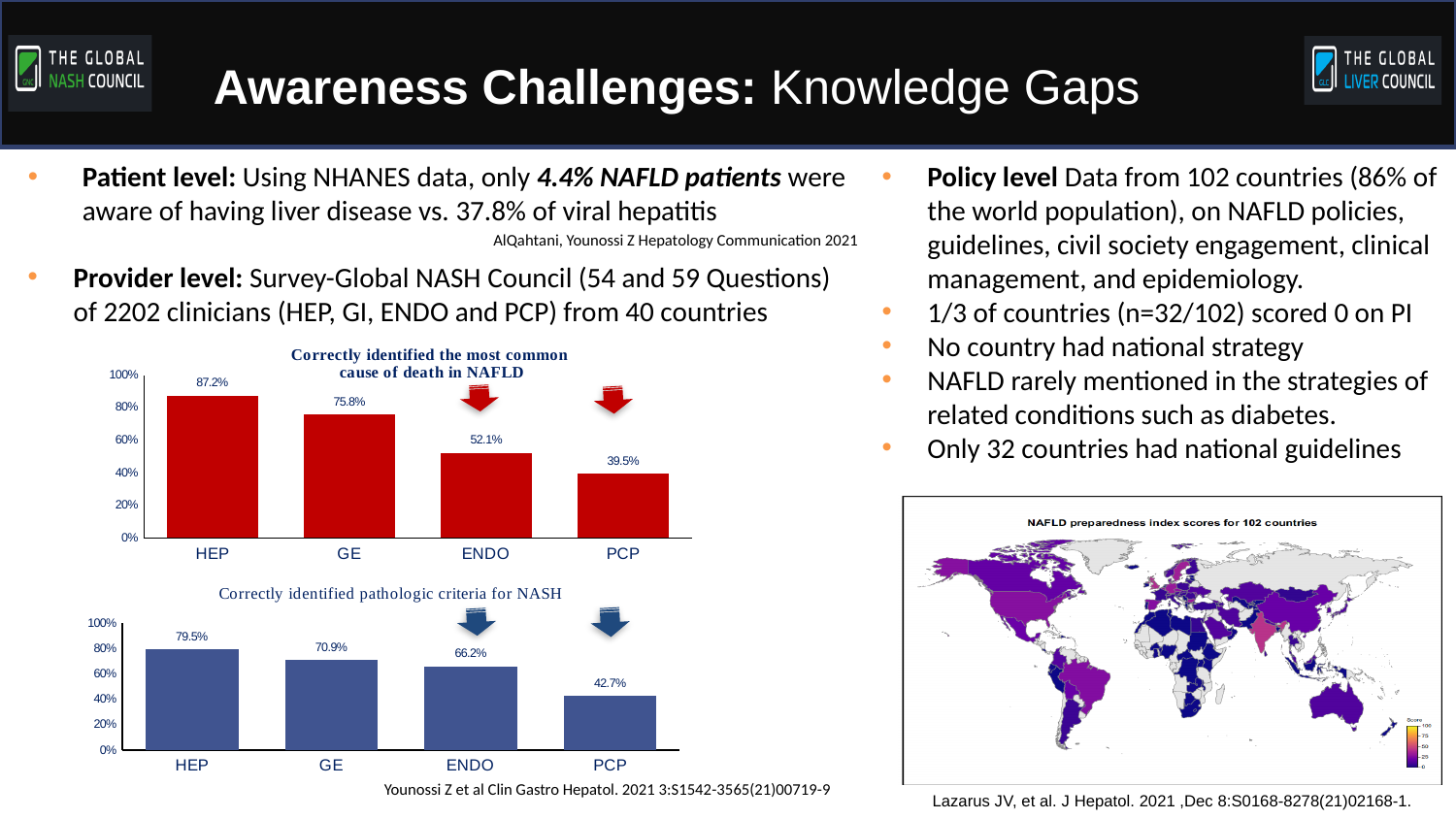
In the chart titled 'Correctly identified the most common cause of death in NAFLD', which category has the lowest value? PCP In the chart titled 'Correctly identified pathologic criteria for NASH', do the values rise or fall from HEP to PCP along the x axis? fall In the chart titled 'Correctly identified the most common cause of death in NAFLD', what is the value for HEP? 87.2% In the chart titled 'Correctly identified the most common cause of death in NAFLD', what is the value for PCP? 39.5% In the chart titled 'Correctly identified pathologic criteria for NASH', which category has the highest value? HEP In the chart titled 'Correctly identified pathologic criteria for NASH', is the value for PCP greater or less than 60%? less In the chart titled 'Correctly identified pathologic criteria for NASH', what is the difference between the HEP and PCP values? 36.8% In the chart titled 'Correctly identified the most common cause of death in NAFLD', how many categories are shown on the x axis? 4 What kind of chart is the chart titled 'Correctly identified the most common cause of death in NAFLD'? bar chart In the chart titled 'Correctly identified pathologic criteria for NASH', what is the value for ENDO? 66.2% In the chart titled 'Correctly identified the most common cause of death in NAFLD', what is the difference between the HEP and ENDO values? 35.1% In the chart titled 'Correctly identified pathologic criteria for NASH', what is the value for GE? 70.9%